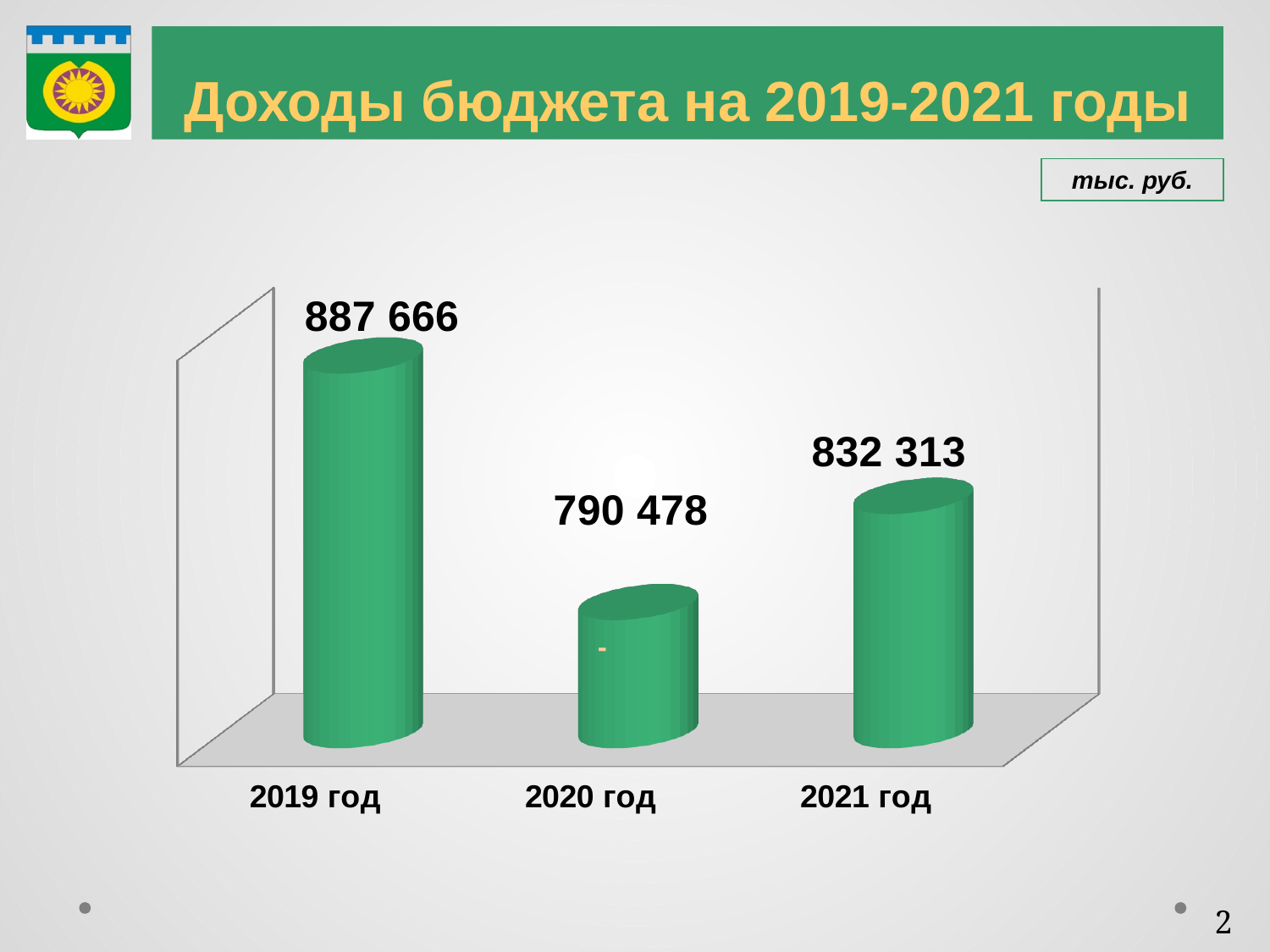
What is the difference between the values for 2019 год and 2020 год? 97 188 What is the title of the chart? Доходы бюджета на 2019-2021 годы What kind of chart is shown on the slide? Bar chart Does the value rise or fall from 2019 год to 2020 год? Fall Which is larger, the value for 2021 год or the value for 2020 год? 2021 год How many years are shown in the chart? 3 Which year has the lowest value? 2020 год Which year has the highest value? 2019 год What is the value for 2021 год? 832 313 What is the value for 2019 год? 887 666 What is the difference between the values for 2021 год and 2020 год? 41 835 What is the value for 2020 год? 790 478